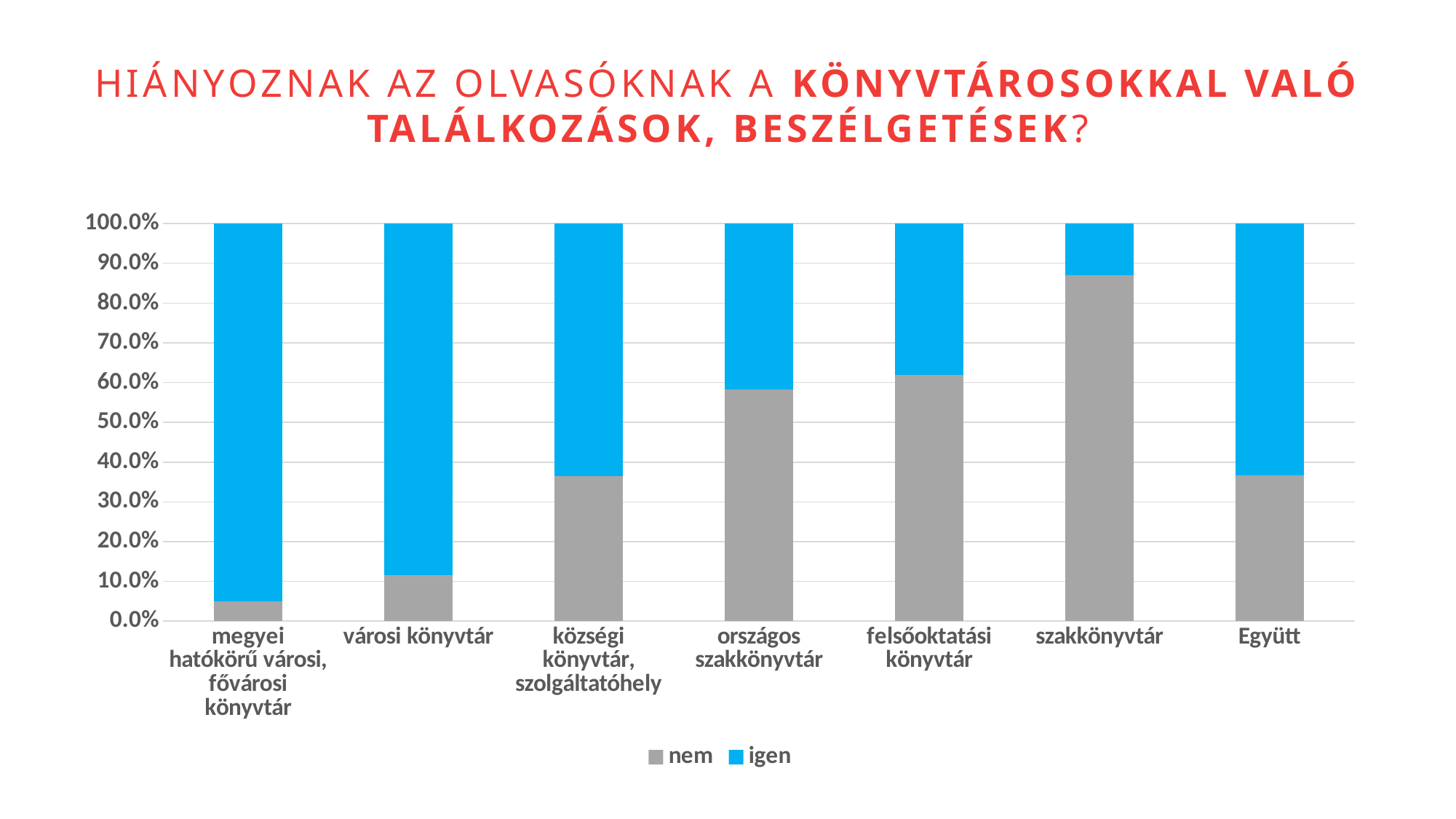
How many series does the legend list? 2 Which series is shown in grey according to the legend? nem What kind of chart is shown on the slide? stacked bar chart What is the total height of the stacked bar for Együtt? 100.0% Which has the larger 'nem' share: városi könyvtár or szakkönyvtár? szakkönyvtár How many library categories are shown on the x axis? 7 Which category has the largest 'igen' share? megyei hatókörű városi, fővárosi könyvtár Which category has the largest 'nem' share? szakkönyvtár Is the 'nem' value for megyei hatókörű városi, fővárosi könyvtár greater or less than 10.0%? less Is the 'nem' value for országos szakkönyvtár greater or less than 50.0%? greater Is the 'nem' value for szakkönyvtár greater or less than 80.0%? greater Which category has the smallest 'nem' share? megyei hatókörű városi, fővárosi könyvtár